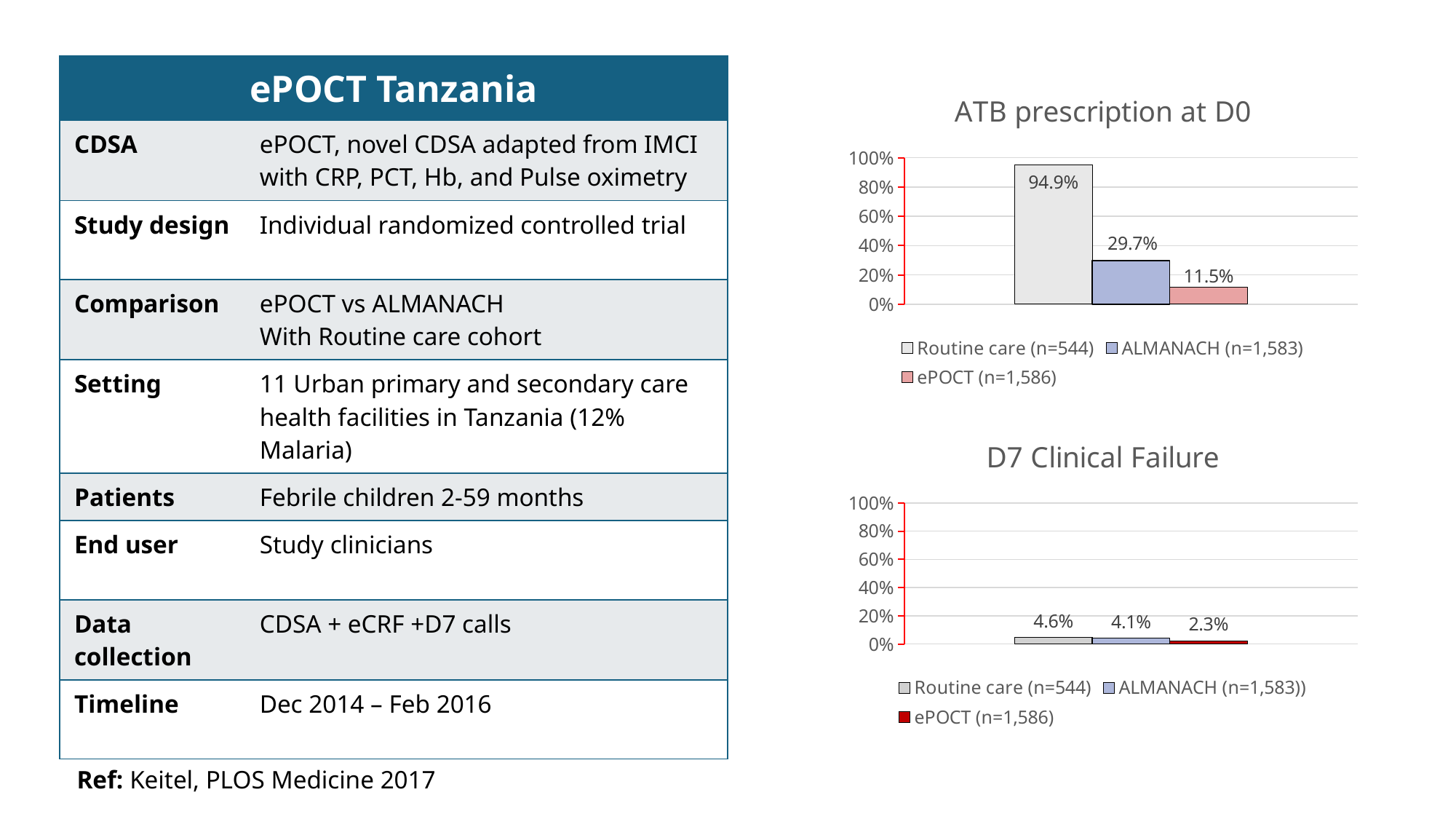
In the 'ATB prescription at D0' chart, which series has the lowest value? ePOCT (n=1,586) In the 'ATB prescription at D0' chart, is the value for ALMANACH (n=1,583) greater or less than 40%? less In the 'ATB prescription at D0' chart, what is the value for Routine care (n=544)? 94.9% How many series does the legend of the 'D7 Clinical Failure' chart list? 3 In the 'D7 Clinical Failure' chart, what is the difference between the Routine care and ePOCT values? 2.3% In the 'D7 Clinical Failure' chart, which is larger, the value for Routine care or the value for ePOCT? Routine care In the 'D7 Clinical Failure' chart, what colour is the ePOCT bar? Dark red In the 'D7 Clinical Failure' chart, which series has the highest value? Routine care (n=544) In the 'ATB prescription at D0' chart, what is the difference between the Routine care and ALMANACH values? 65.2% What kind of chart is the 'ATB prescription at D0' chart? Bar chart In the 'D7 Clinical Failure' chart, what is the value for ALMANACH? 4.1% In the 'ATB prescription at D0' chart, what is the value for ePOCT (n=1,586)? 11.5%